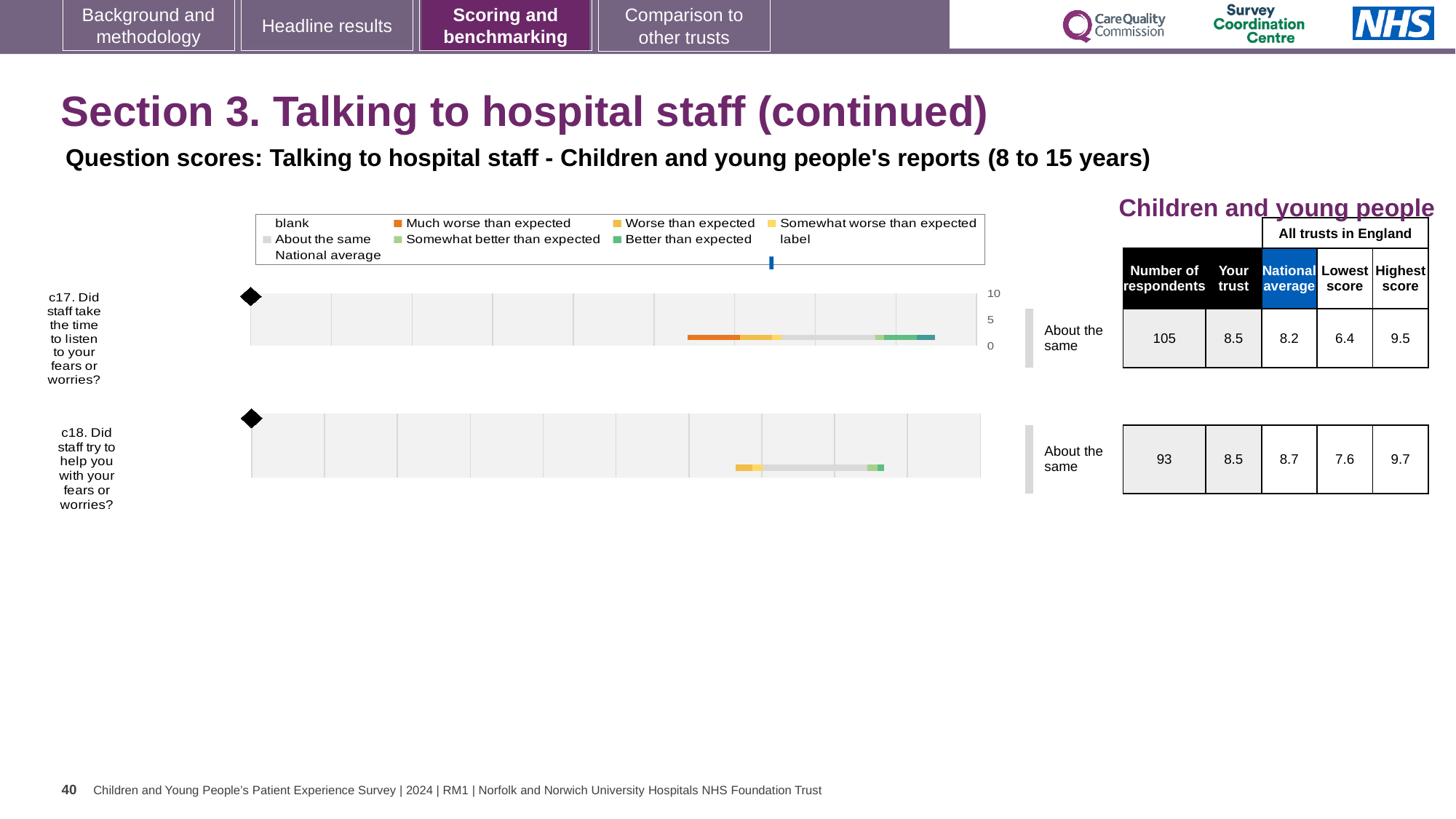
For c17, which is larger: the 'Your trust' score or the national average? Your trust What is the highest score among all trusts in England for c17? 9.5 What is the lowest score among all trusts in England for c18? 7.6 What kind of chart is used to show the scores for c17 and c18? bar chart For c18, which is larger: the 'Your trust' score or the national average? National average For c18, what is the difference between the highest score (9.7) and the lowest score (7.6)? 2.1 What is the national average score for c17? 8.2 How many more respondents answered c17 than c18? 12 What benchmark category is shown next to the bar for c17? About the same How many survey questions are plotted on the slide? 2 What is the 'Your trust' score for c18 (Did staff try to help you with your fears or worries?)? 8.5 What is the number of respondents for c17 (Did staff take the time to listen to your fears or worries?)? 105